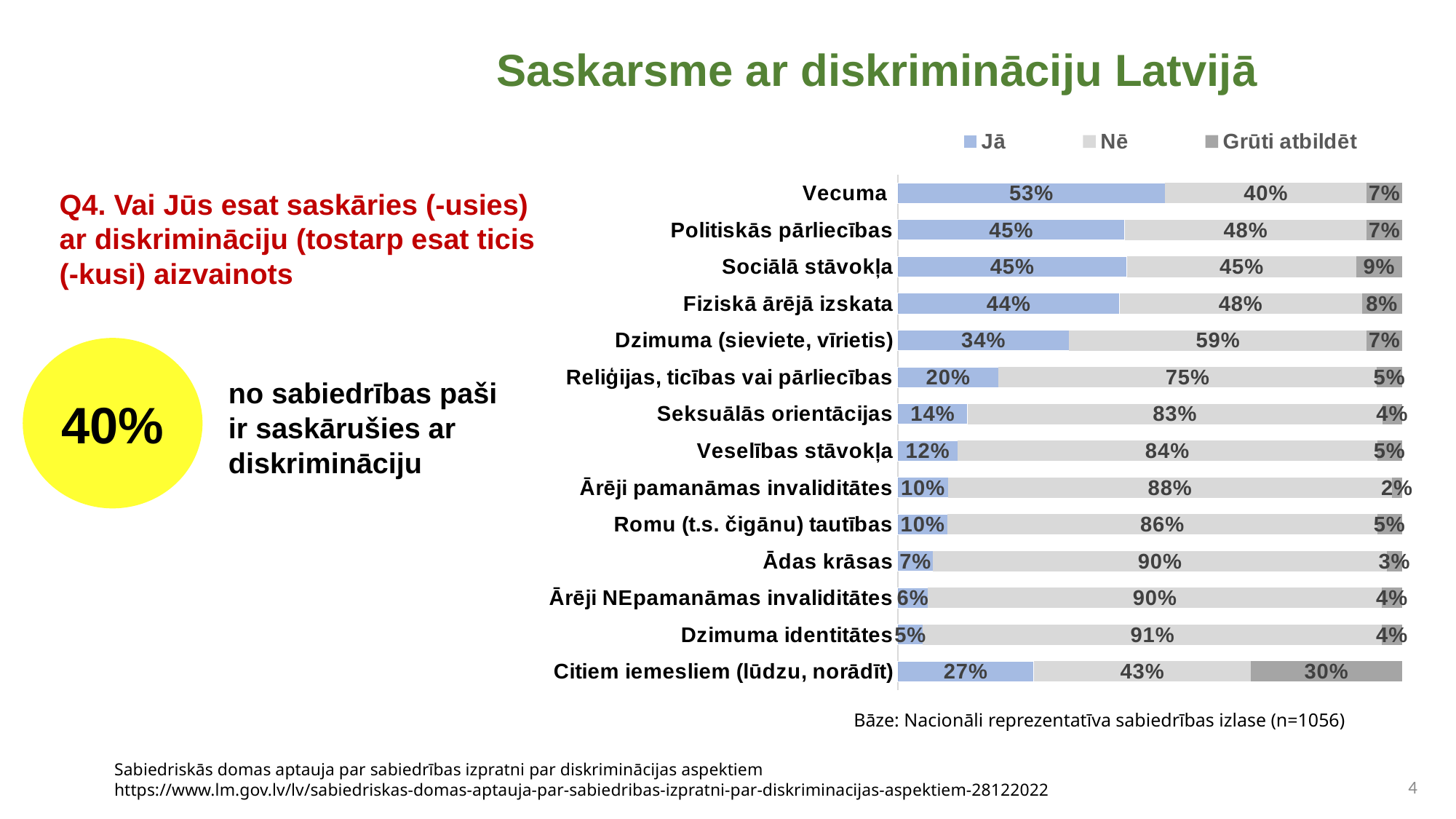
What kind of chart is shown on the slide? Stacked bar chart Which category has the highest "Jā" value? Vecuma How many series does the legend list? 3 What is the "Jā" value for Vecuma? 53% Which category has the lowest "Jā" value? Dzimuma identitātes What is the "Grūti atbildēt" value for Citiem iemesliem (lūdzu, norādīt)? 30% What is the "Nē" value for Seksuālās orientācijas? 83% What is the difference between the "Nē" values for Dzimuma (sieviete, vīrietis) and Vecuma? 19% What is the title of the slide's chart section? Saskarsme ar diskrimināciju Latvijā What is the total of the stacked bar for Sociālā stāvokļa? 99% Which is larger: the "Jā" value for Politiskās pārliecības or the "Jā" value for Dzimuma (sieviete, vīrietis)? Politiskās pārliecības How many categories are shown in the chart? 14